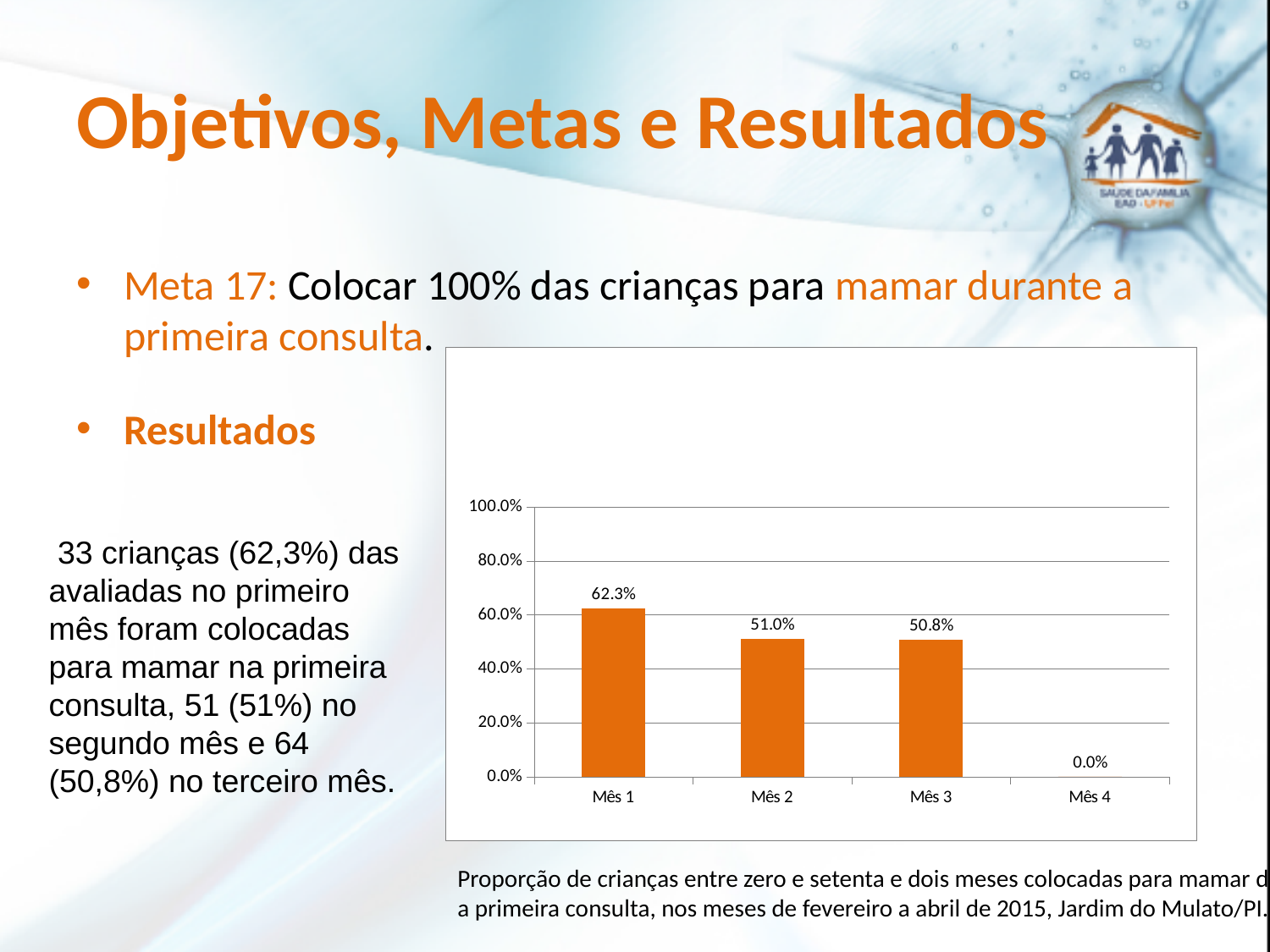
What kind of chart is shown on the slide? Bar chart What is the difference between the values for Mês 2 and Mês 3? 0.2% What is the difference between the values for Mês 1 and Mês 2? 11.3% What is the value for Mês 3? 50.8% What is the value for Mês 1? 62.3% What is the value for Mês 4? 0.0% Which is larger, the value for Mês 1 or the value for Mês 3? Mês 1 Which month has the highest value? Mês 1 Is the value for Mês 1 greater or less than 60.0%? greater What is the value for Mês 2? 51.0% Which month has the lowest value? Mês 4 How many months are shown on the x axis? 4